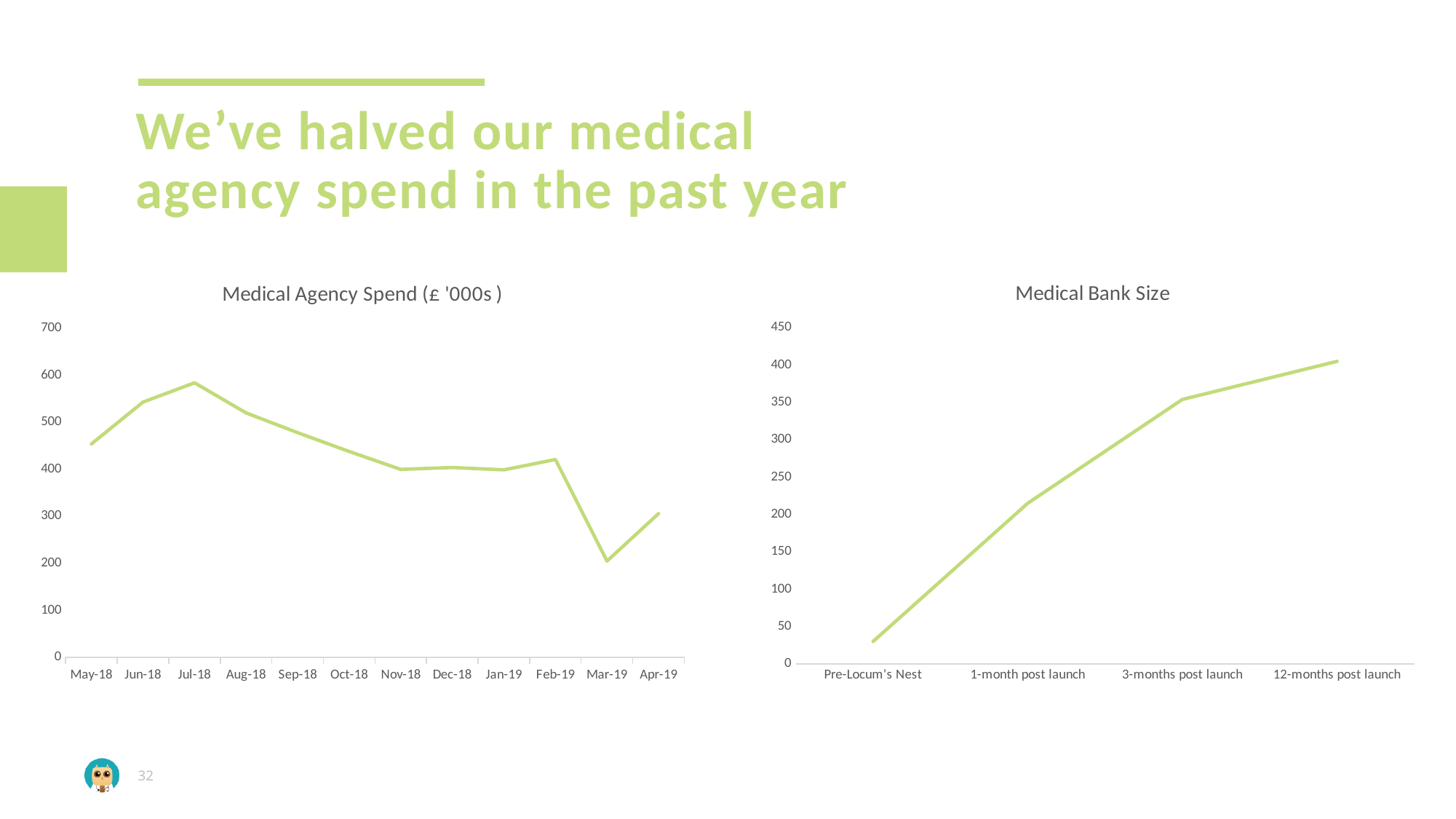
What kind of chart is the Medical Bank Size chart? line chart What kind of chart is the Medical Agency Spend (£ '000s) chart? line chart What is the title of the chart on the right of the slide? Medical Bank Size In the Medical Agency Spend (£ '000s) chart, which month has the highest spend? Jul-18 In the Medical Agency Spend (£ '000s) chart, is the value for Jul-18 greater or less than 500? greater How many points are plotted on the Medical Bank Size chart? 4 In the Medical Bank Size chart, is the value for Pre-Locum's Nest greater or less than 50? less In the Medical Agency Spend (£ '000s) chart, which month has the lowest spend? Mar-19 In the Medical Agency Spend (£ '000s) chart, which is larger, the value for Jun-18 or the value for Dec-18? Jun-18 How many months are plotted on the Medical Agency Spend (£ '000s) chart? 12 In the Medical Agency Spend (£ '000s) chart, is the value for Mar-19 greater or less than 300? less In the Medical Bank Size chart, do the values rise or fall from Pre-Locum's Nest to 12-months post launch? rise